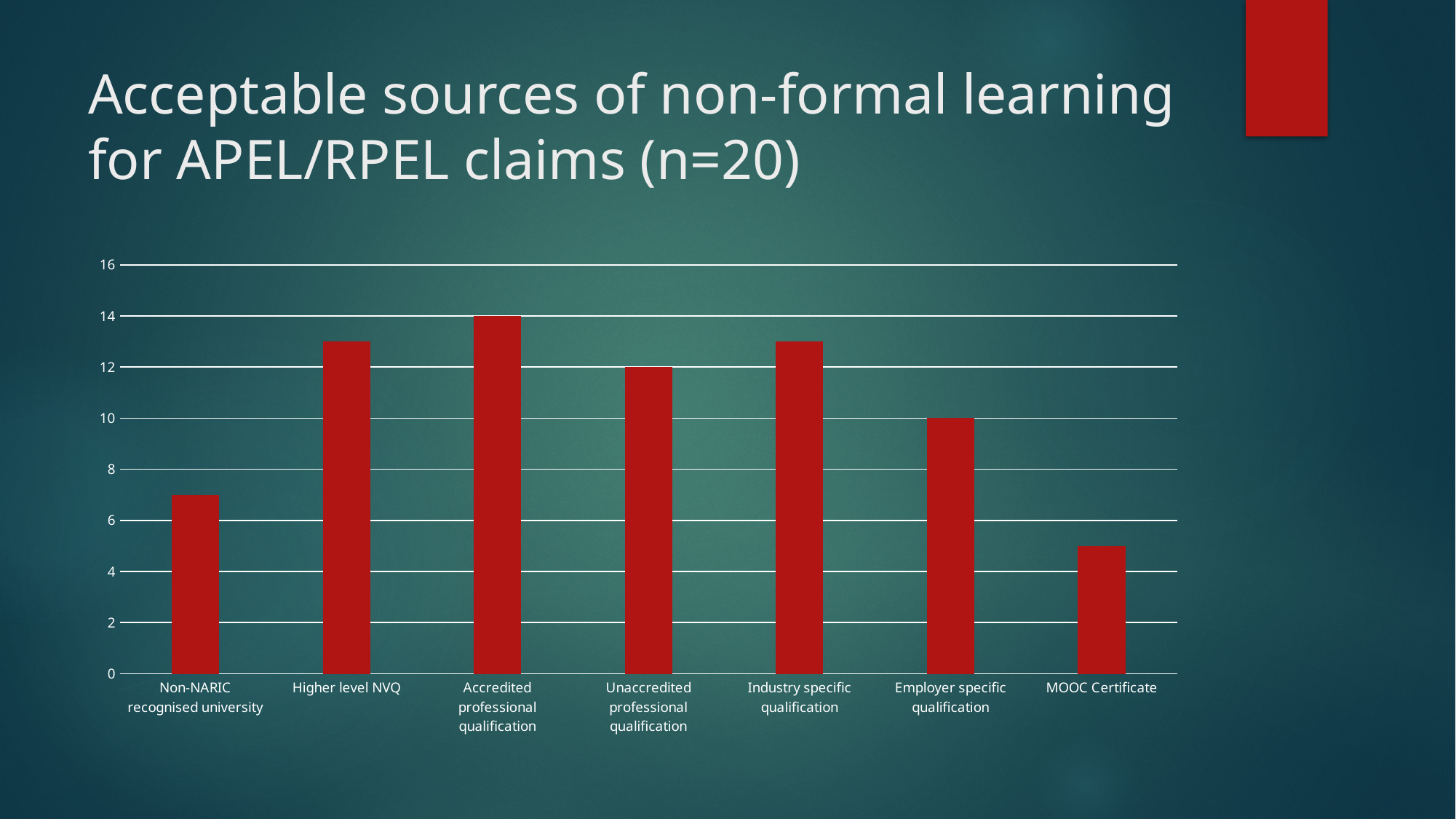
What is the value for Unaccredited professional qualification? 12 What is the difference between the values for Accredited professional qualification and Employer specific qualification? 4 Which is larger, the value for Non-NARIC recognised university or the value for Employer specific qualification? Employer specific qualification Is the value for MOOC Certificate greater or less than 6? less Which category has the highest value? Accredited professional qualification What is the value for Employer specific qualification? 10 What is the difference between the values for Accredited professional qualification and Unaccredited professional qualification? 2 Which category has the lowest value? MOOC Certificate What is the value for Accredited professional qualification? 14 How many categories are shown on the x axis of the chart? 7 Is the value for Higher level NVQ greater or less than 12? greater What type of chart is shown on the slide? Bar chart